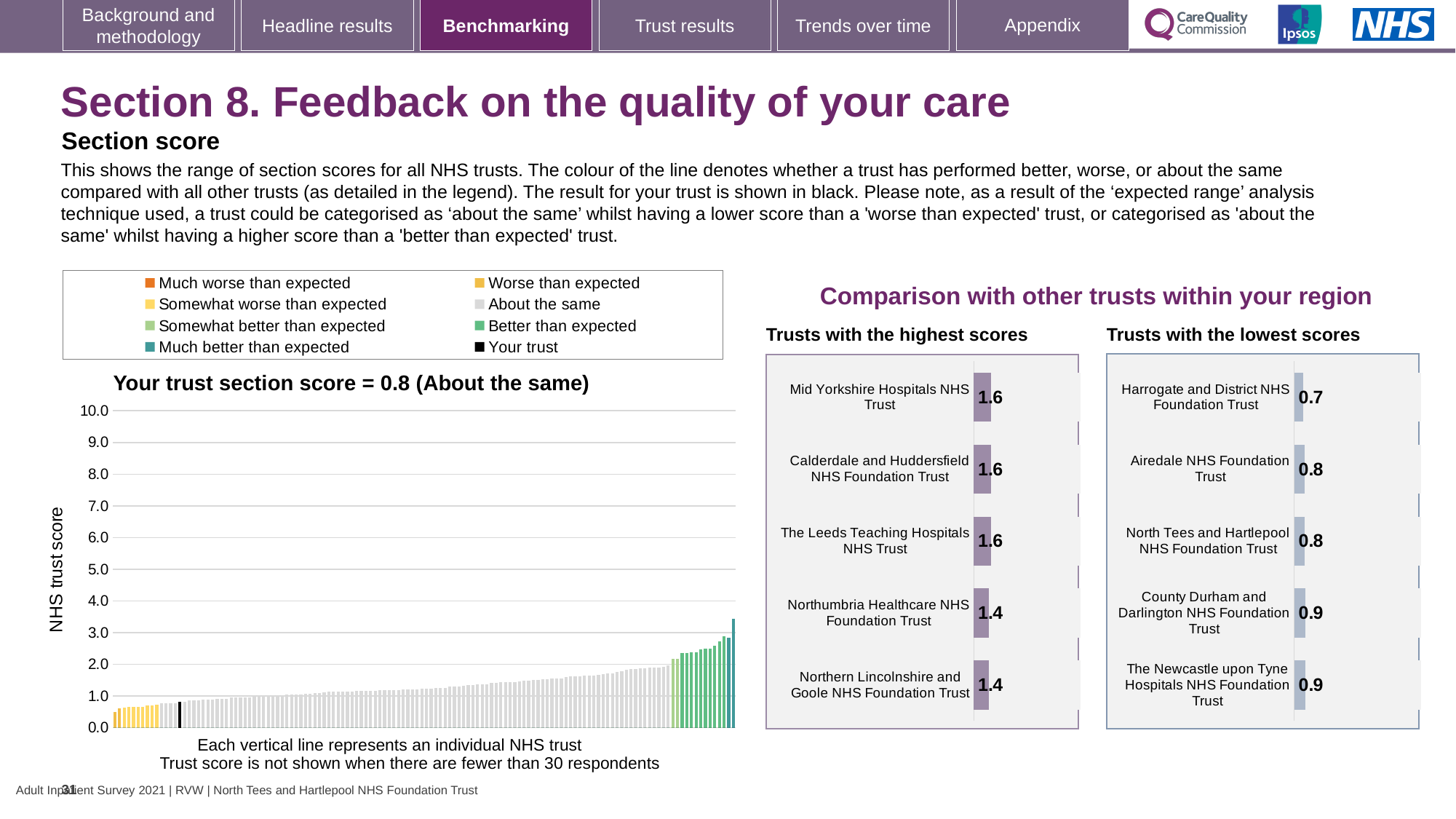
On the 'Trusts with the lowest scores' chart, which trust has the lowest score? Harrogate and District NHS Foundation Trust On the 'Trusts with the highest scores' chart, what is the score for Northumbria Healthcare NHS Foundation Trust? 1.4 On the 'Your trust section score' chart, is the tallest bar greater or less than 4.0? less On the 'Trusts with the lowest scores' chart, what is the score for Airedale NHS Foundation Trust? 0.8 What is the y-axis label on the 'Your trust section score' chart? NHS trust score What kind of chart is the 'Your trust section score' chart? bar chart On the 'Trusts with the lowest scores' chart, which has the larger score: Harrogate and District NHS Foundation Trust or County Durham and Darlington NHS Foundation Trust? County Durham and Darlington NHS Foundation Trust How many entries does the legend above the 'Your trust section score' chart list? 8 On the 'Trusts with the highest scores' chart, what is the difference between the scores of Mid Yorkshire Hospitals NHS Trust and Northern Lincolnshire and Goole NHS Foundation Trust? 0.2 On the 'Trusts with the highest scores' chart, how many trusts are shown? 5 On the 'Your trust section score' chart, do the bars rise or fall from left to right? rise On the 'Your trust section score' chart, what is the section score for your trust? 0.8